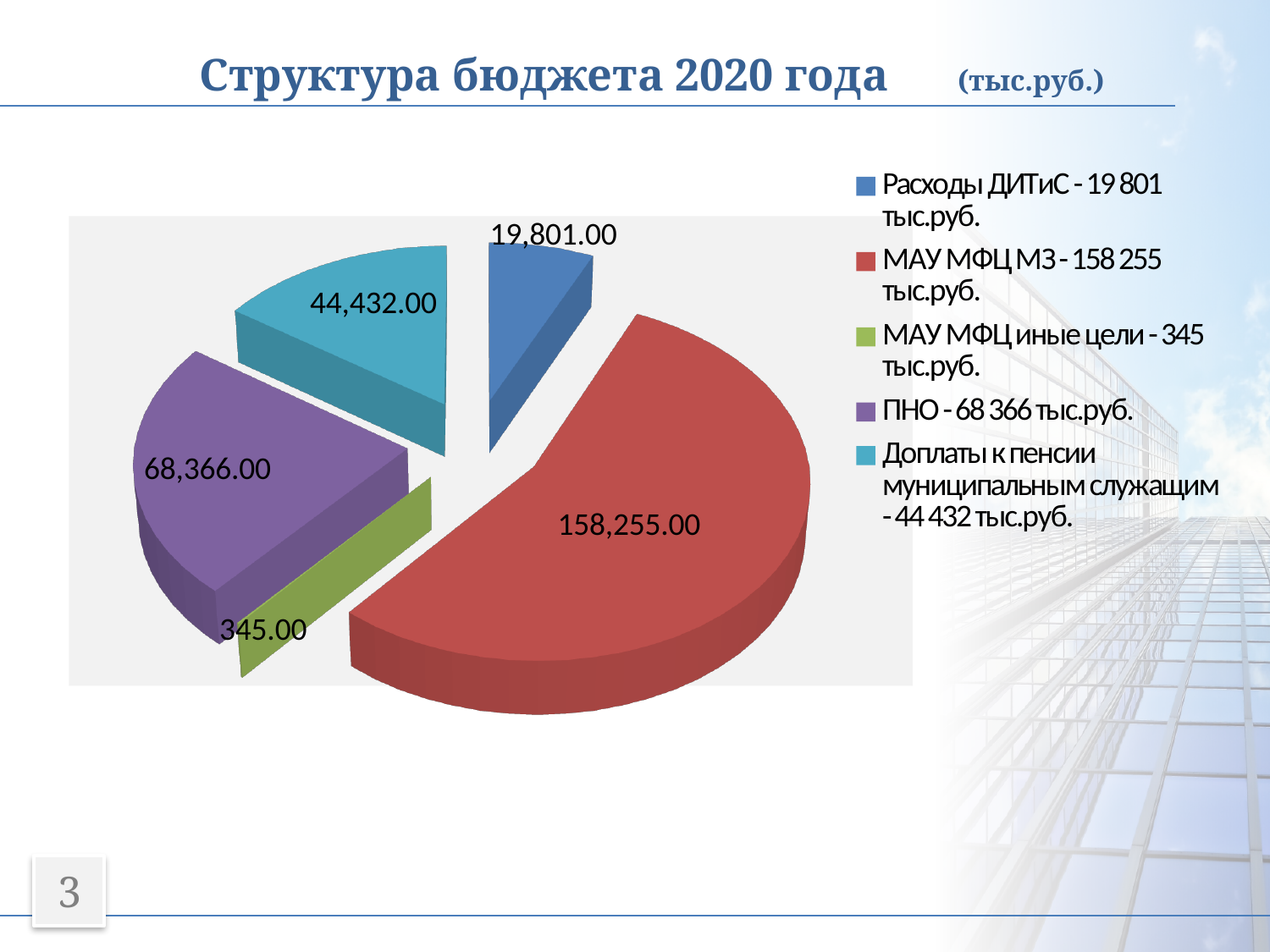
What is the difference between the values for ПНО and Доплаты к пенсии муниципальным служащим? 23,934.00 Which is larger, the value for Расходы ДИТиС or the value for Доплаты к пенсии муниципальным служащим? Доплаты к пенсии муниципальным служащим How many entries does the legend list? 5 What is the value shown for Доплаты к пенсии муниципальным служащим? 44,432.00 What is the value shown for МАУ МФЦ МЗ? 158,255.00 What is the value shown for ПНО? 68,366.00 What is the title of the chart on the slide? Структура бюджета 2020 года (тыс.руб.) How many slices does the pie chart have? 5 What is the value shown for Расходы ДИТиС? 19,801.00 Which category has the largest slice of the pie? МАУ МФЦ МЗ What kind of chart is shown on the slide? Pie chart Which category has the smallest slice of the pie? МАУ МФЦ иные цели